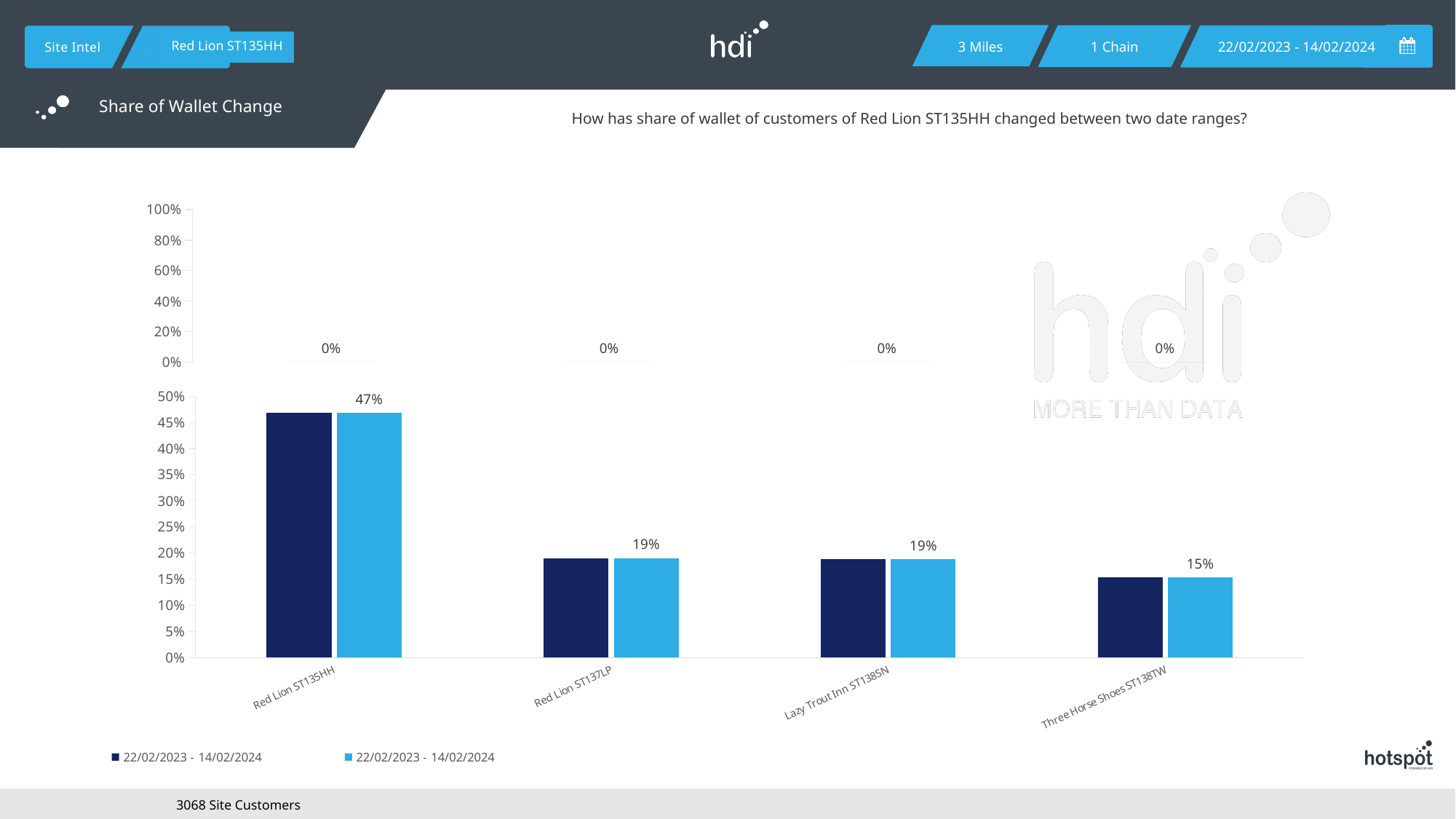
Is the share of wallet for Red Lion ST135HH greater or less than 40%? greater What is the difference between the labelled share of wallet for Red Lion ST135HH and Three Horse Shoes ST138TW? 32% Which category has the highest share of wallet in the lower panel? Red Lion ST135HH What is the share of wallet value labelled for Three Horse Shoes ST138TW in the lower panel? 15% How many series does the legend list? 2 What change value is shown for Red Lion ST137LP in the upper panel? 0% How many categories are shown on the x axis of the chart? 4 What kind of chart is shown on the slide? bar chart What is the title of the chart section on the slide? Share of Wallet Change What is the share of wallet value labelled for Lazy Trout Inn ST138SN in the lower panel? 19% Which category has the lowest share of wallet in the lower panel? Three Horse Shoes ST138TW What is the share of wallet value labelled for Red Lion ST135HH in the lower panel? 47%